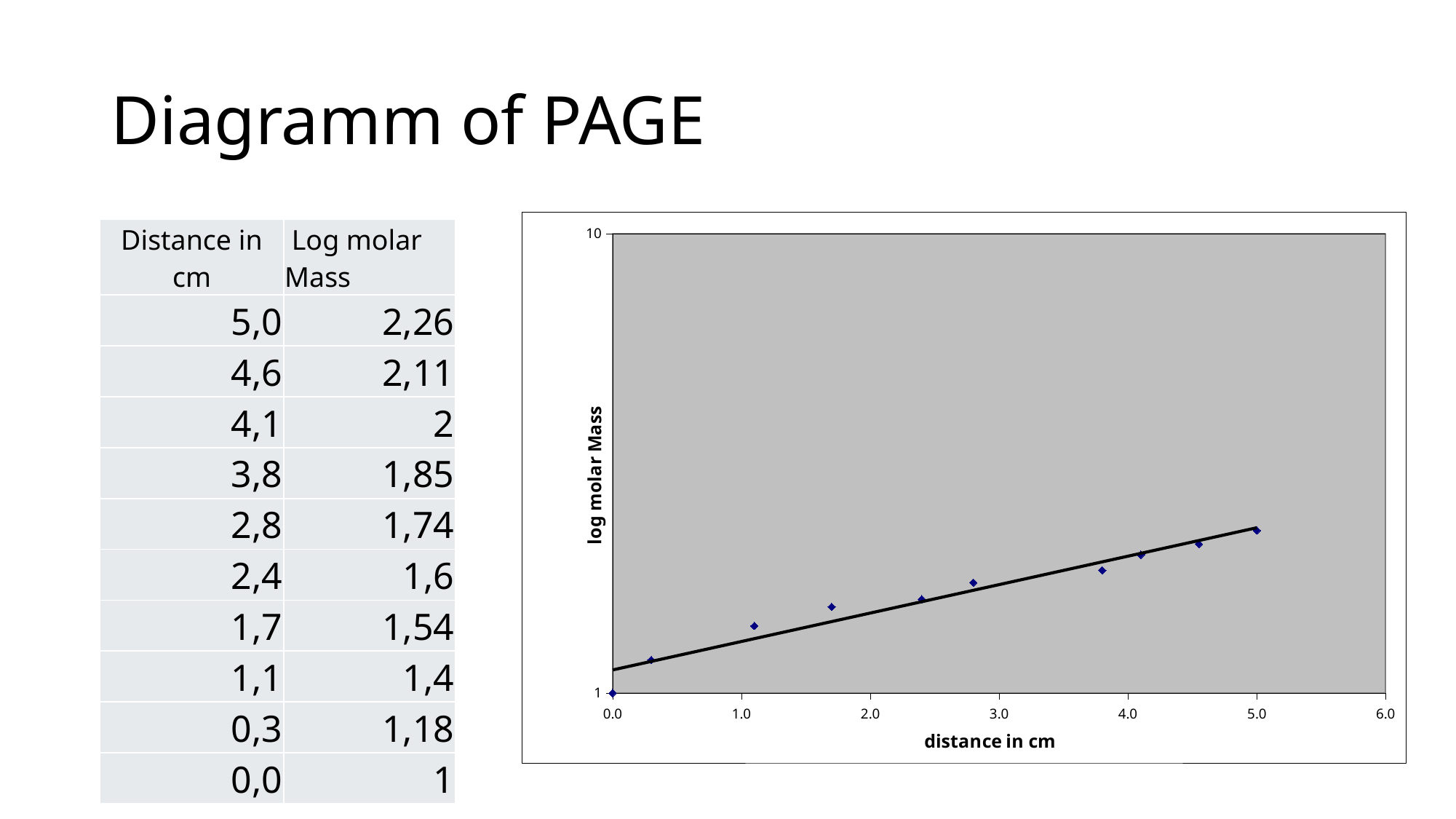
What is the label of the x axis of the chart? distance in cm According to the table on the slide, what is the log molar Mass at a distance of 5,0 cm? 2,26 Do the plotted values rise or fall as distance in cm increases? rise What kind of chart is shown on the slide? scatter chart At which distance in cm is the plotted log molar Mass highest? 5.0 How many data points are plotted in the chart? 10 According to the table on the slide, what is the log molar Mass at a distance of 2,4 cm? 1,6 Which has the larger log molar Mass: the point at 1.1 cm or the point at 4.1 cm? 4.1 cm At which distance in cm is the plotted log molar Mass lowest? 0.0 Is the log molar Mass at a distance of 3.8 cm greater or less than 1? greater Is the log molar Mass at a distance of 5.0 cm greater or less than 10? less What is the label of the y axis of the chart? log molar Mass